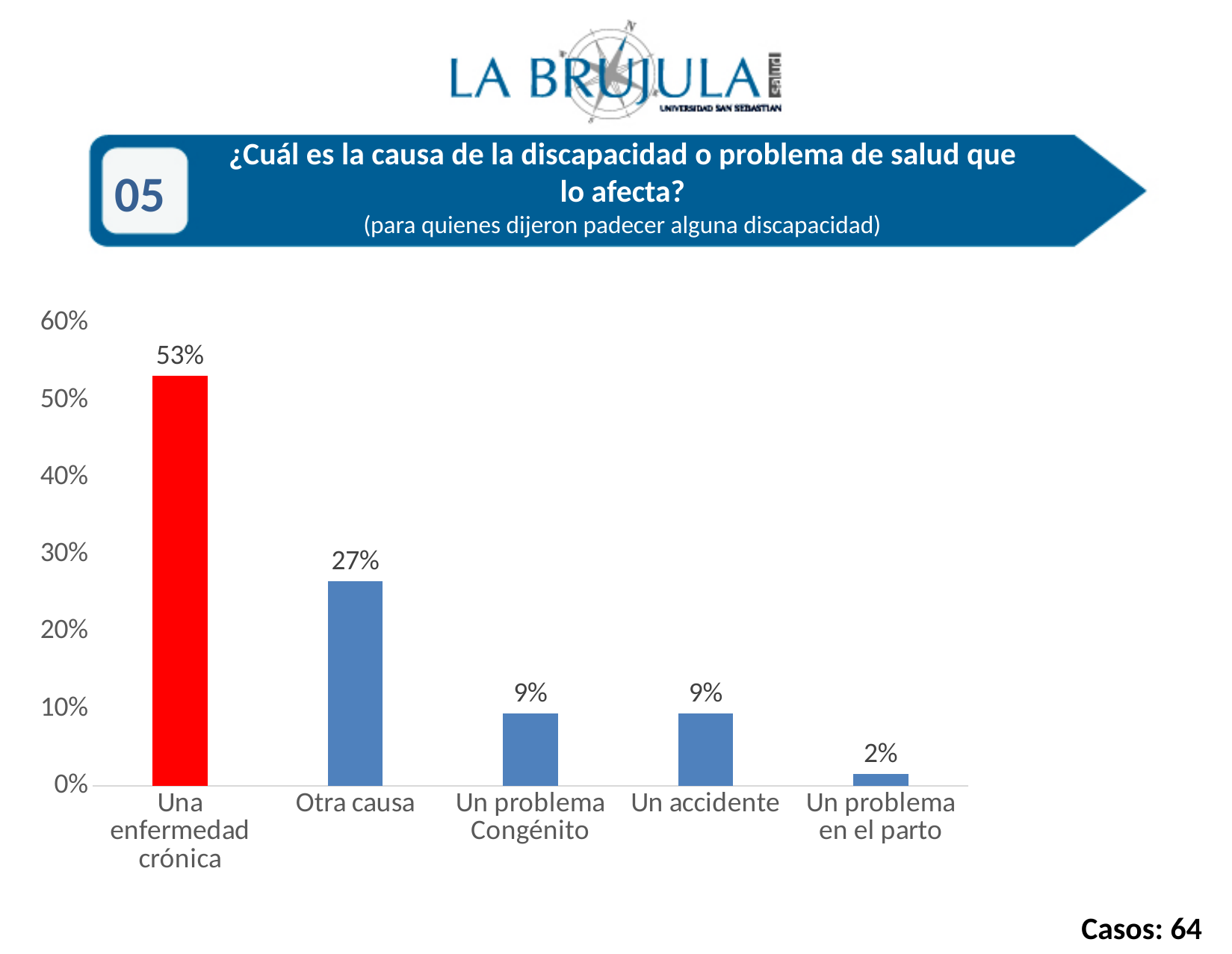
Which bar is coloured red? Una enfermedad crónica Is the value for "Una enfermedad crónica" greater or less than 50%? greater What is the value for "Un problema en el parto"? 2% What is the value for "Otra causa"? 27% Which is larger, the value for "Otra causa" or the value for "Un problema Congénito"? Otra causa What is the difference between the values for "Una enfermedad crónica" and "Otra causa"? 26% Which category has the highest value? Una enfermedad crónica What is the value for "Un accidente"? 9% What kind of chart is shown on the slide? bar chart What is the value for "Una enfermedad crónica"? 53% How many categories are shown in the chart? 5 Which category has the lowest value? Un problema en el parto